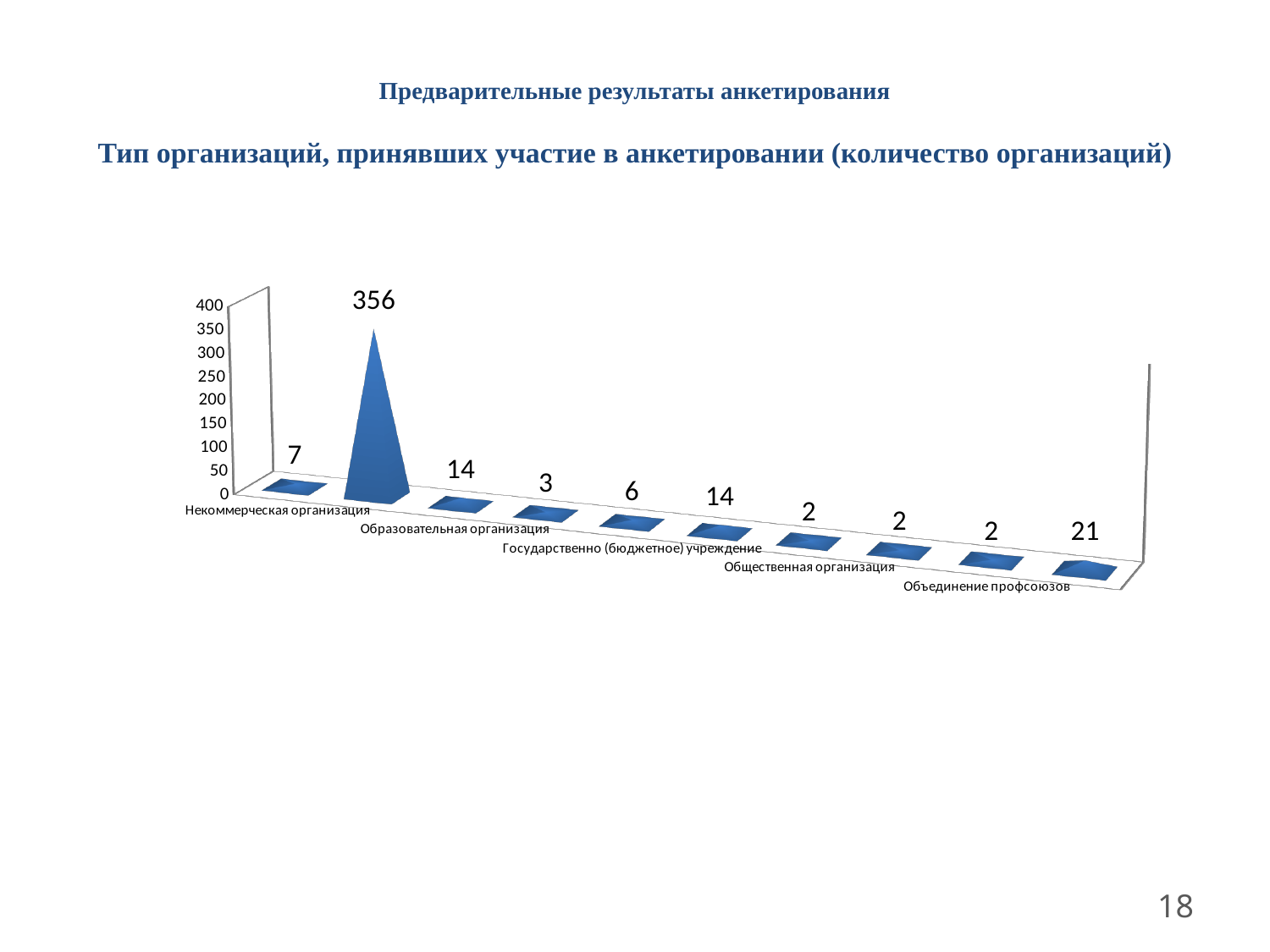
What is the difference between the value for Образовательная организация and the value for Некоммерческая организация? 7 What is the maximum value shown on the vertical axis? 400 What is the value for Некоммерческая организация? 7 What is the value for Общественная организация? 2 What is the highest value shown in the chart? 356 How many categories are plotted in the chart? 10 What is the lowest value shown in the chart? 2 What is the value for Объединение профсоюзов? 2 Which is larger, the value for Государственно (бюджетное) учреждение or the value for Общественная организация? Государственно (бюджетное) учреждение What is the value for Образовательная организация? 14 Is the highest value in the chart greater or less than 300? greater What is the value for Государственно (бюджетное) учреждение? 6